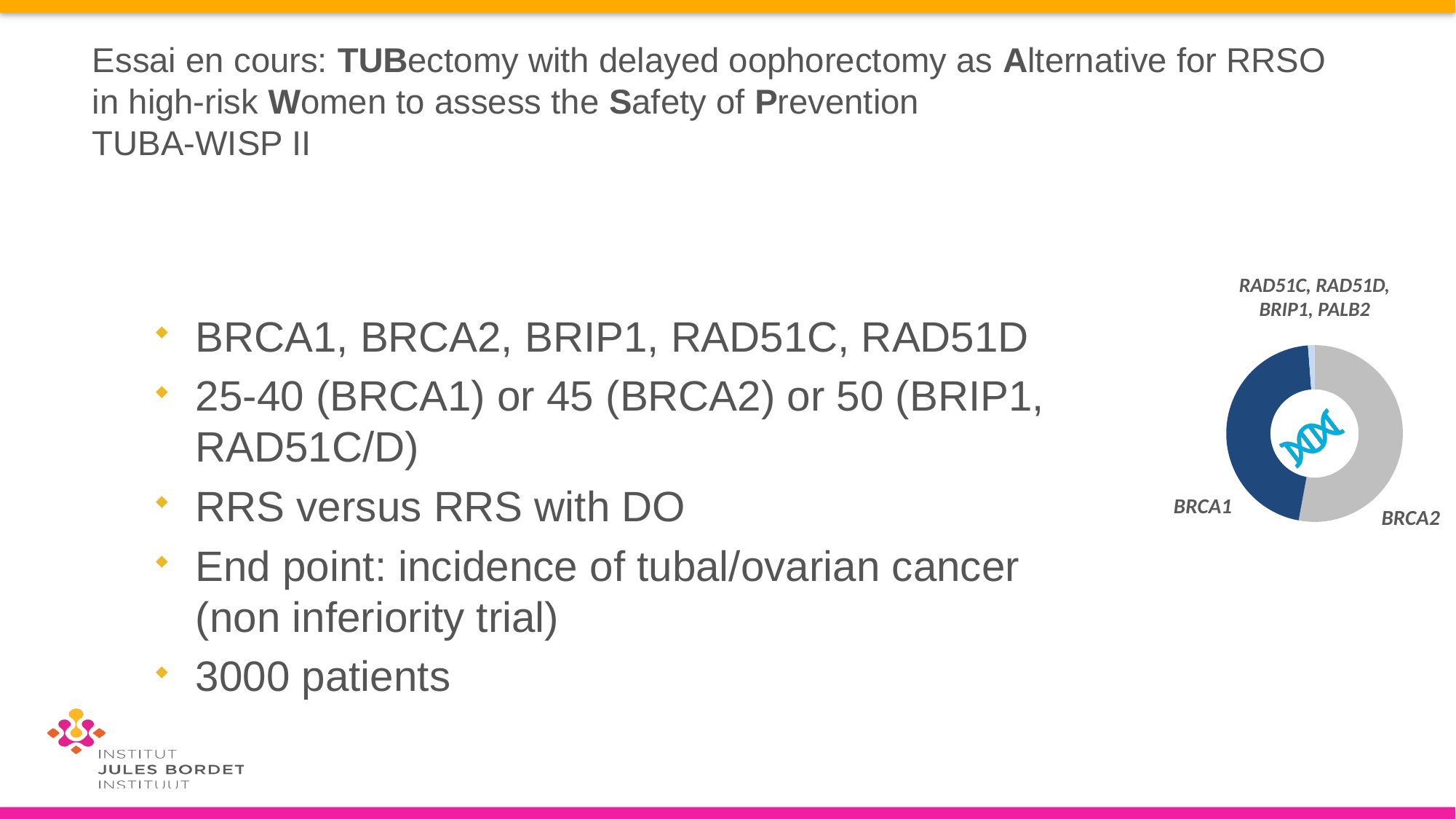
What colour is the BRCA2 slice in the donut chart? Grey Which is larger in the donut chart: the BRCA1 slice or the RAD51C, RAD51D, BRIP1, PALB2 slice? BRCA1 Which is larger in the donut chart: the BRCA2 slice or the RAD51C, RAD51D, BRIP1, PALB2 slice? BRCA2 What colour is the BRCA1 slice in the donut chart? Dark blue How many slices does the donut chart have? 3 Which genes are grouped together in the smallest slice of the donut chart? RAD51C, RAD51D, BRIP1, PALB2 What kind of chart is shown on the right of the slide? Donut (pie) chart Which slice of the donut chart is the smallest? RAD51C, RAD51D, BRIP1, PALB2